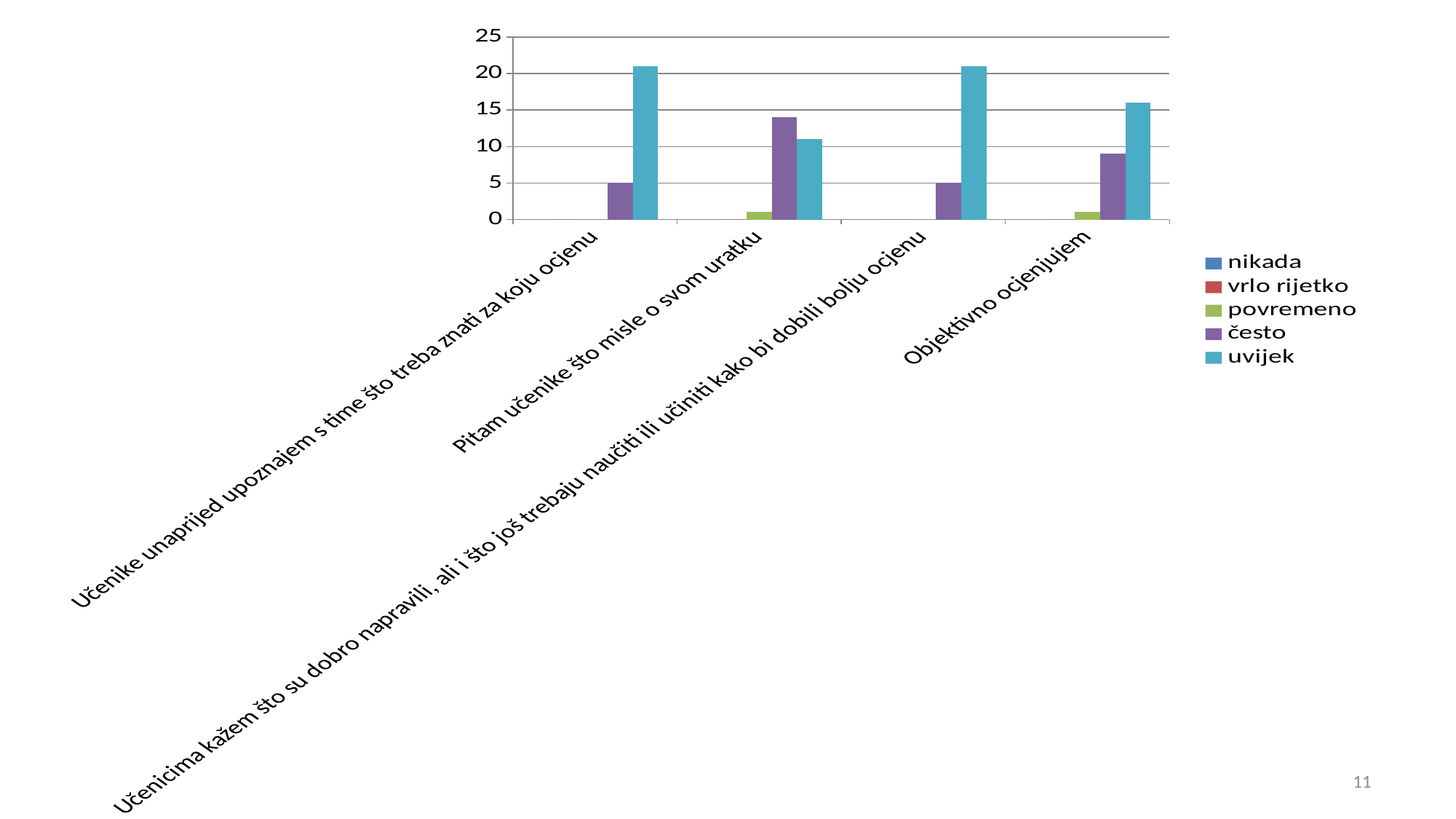
Is the value of 'uvijek' for 'Pitam učenike što misle o svom uratku' greater or less than 15? less For 'Pitam učenike što misle o svom uratku', which is larger: 'često' or 'uvijek'? često For 'Objektivno ocjenjujem', which is larger: 'često' or 'uvijek'? uvijek How many categories are shown on the x axis? 4 What is the value of 'često' for 'Učenike unaprijed upoznajem s time što treba znati za koju ocjenu'? 5 What kind of chart is shown on the slide? bar chart Which series has the tallest bar for 'Učenike unaprijed upoznajem s time što treba znati za koju ocjenu'? uvijek What is the last entry in the legend? uvijek Is the value of 'često' for 'Pitam učenike što misle o svom uratku' greater or less than 10? greater How many series does the legend list? 5 Is the value of 'uvijek' for 'Objektivno ocjenjujem' greater or less than 15? greater